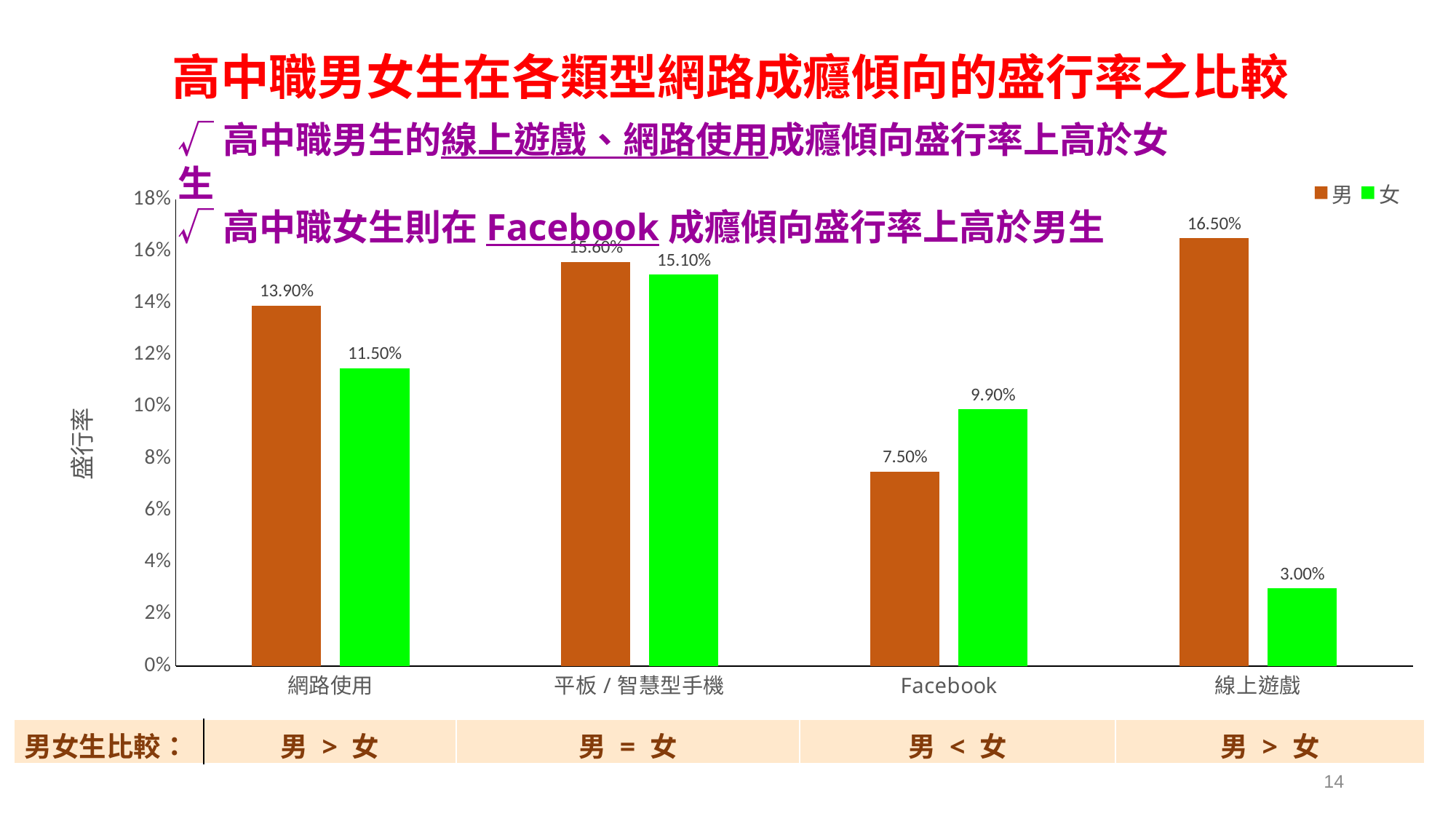
What is the value for 男 in the 網路使用 category? 13.90% What is the value for 男 in the 平板／智慧型手機 category? 15.60% In the Facebook category, which series has the larger value, 男 or 女? 女 Which category has the highest value for 男? 線上遊戲 How many categories are shown on the x axis? 4 Is the value for 女 in the 網路使用 category greater or less than 12%? less Which category has the lowest value for 女? 線上遊戲 What is the value for 女 in the Facebook category? 9.90% What is the value for 女 in the 線上遊戲 category? 3.00% What kind of chart is shown on the slide? bar chart What is the difference between the 男 and 女 values in the 線上遊戲 category? 13.50% How many series does the legend list? 2